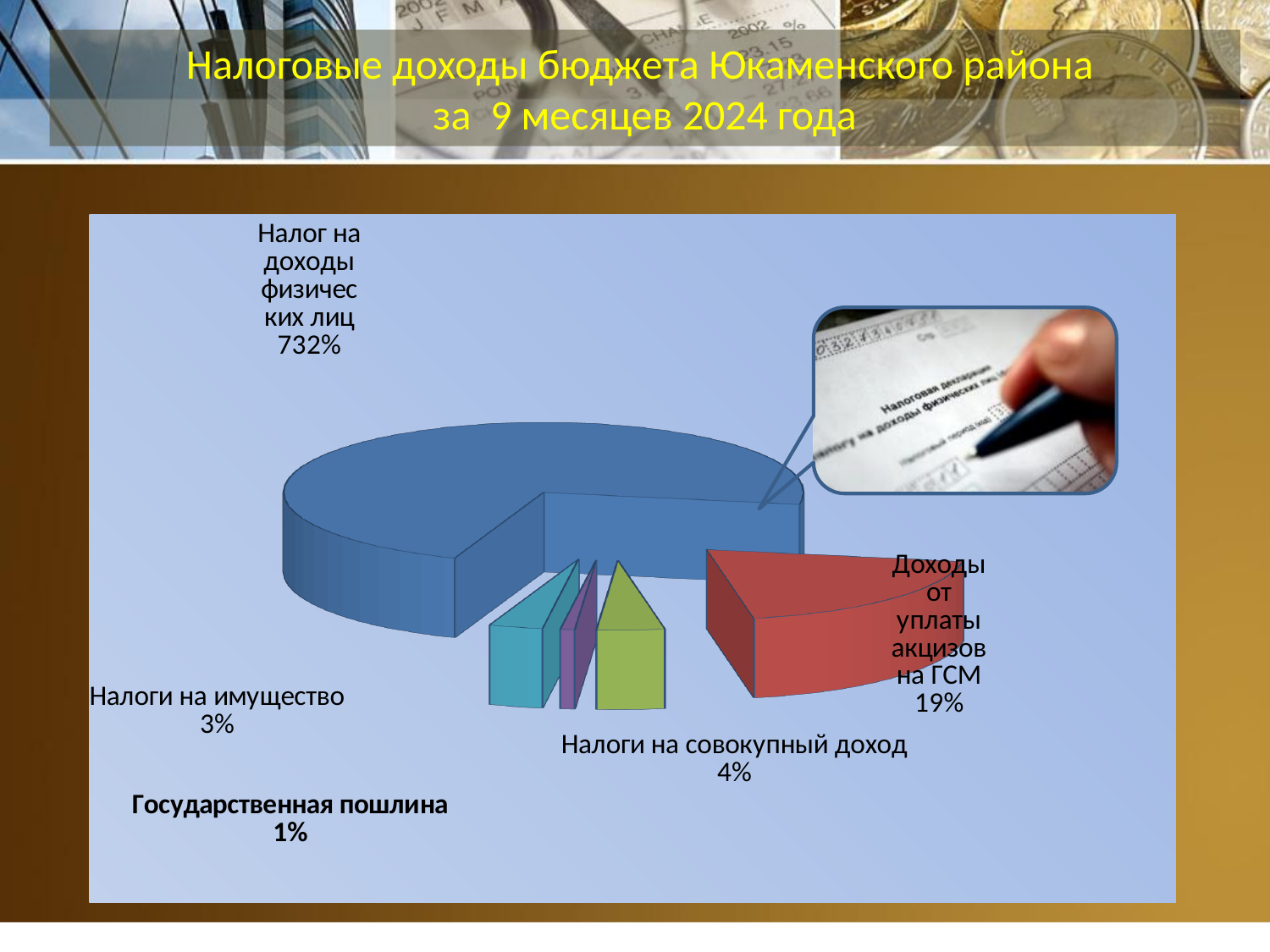
What share is shown for Налоги на совокупный доход? 4% What share is shown for Государственная пошлина? 1% What share is shown for Налоги на имущество? 3% What is the difference in percentage points between Доходы от уплаты акцизов на ГСМ and Налоги на совокупный доход? 15 Which category has the smallest slice of the pie? Государственная пошлина Which category has the largest slice of the pie? Налог на доходы физических лиц Which slice is coloured red? Доходы от уплаты акцизов на ГСМ What is the title of the slide? Налоговые доходы бюджета Юкаменского района за 9 месяцев 2024 года What kind of chart is shown on the slide? Pie chart What value is printed on the label for Налог на доходы физических лиц? 732% How many slices does the pie chart have? 5 What share is shown for Доходы от уплаты акцизов на ГСМ? 19%